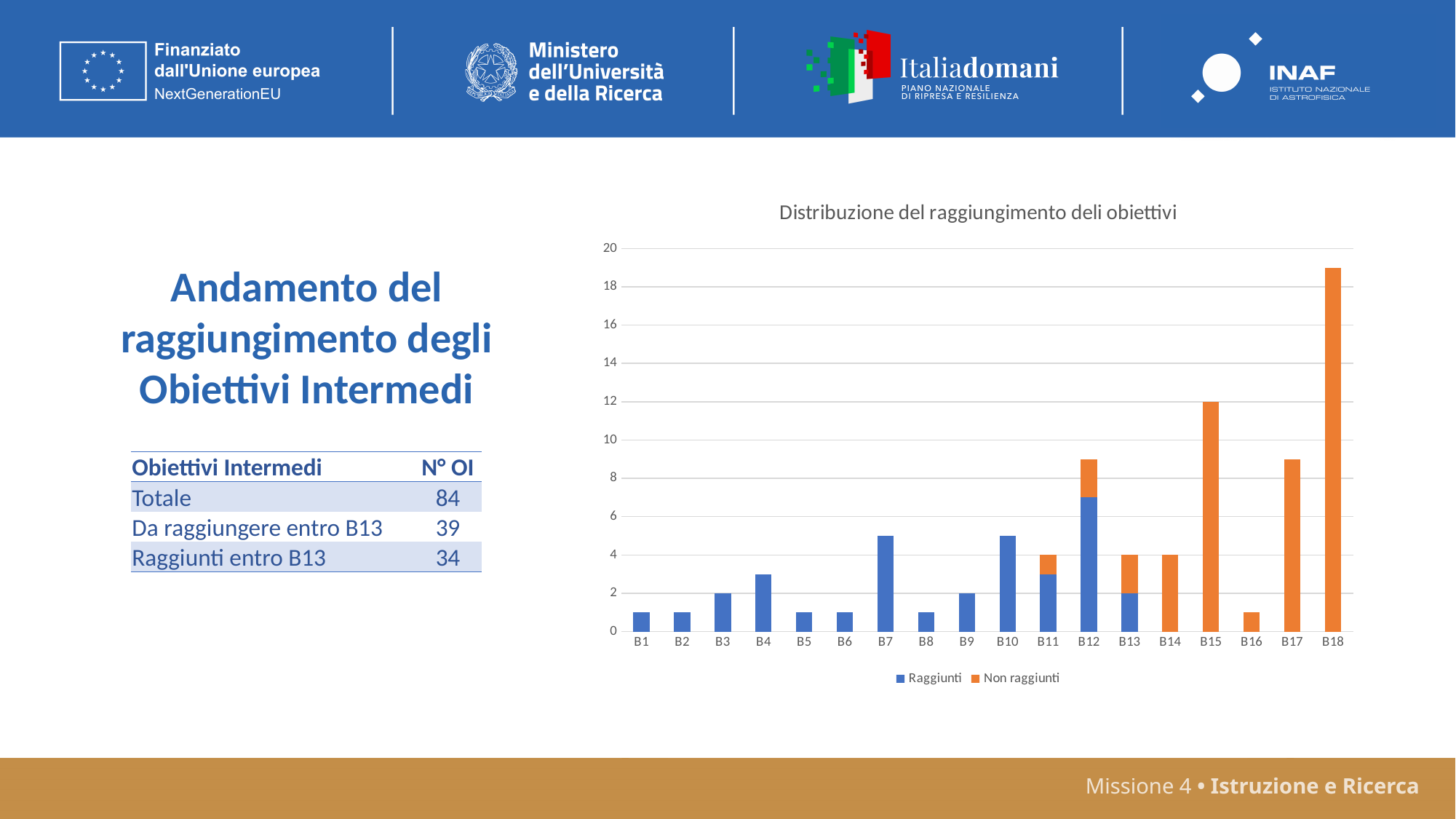
What are the two series named in the chart legend? Raggiunti and Non raggiunti How many categories (B1 to B18) are shown on the x axis of the chart? 18 How many series does the chart legend list? 2 What is the title of the chart? Distribuzione del raggiungimento deli obiettivi Which category has the tallest bar in the chart? B18 What is the value of the Non raggiunti bar for B15? 12 What is the value of the Non raggiunti bar for B14? 4 Is the value for B17 greater or less than 10? less What is the value of the Raggiunti bar for B3? 2 What kind of chart is shown on the slide? bar chart Is the value for B18 greater or less than 18? greater Which is larger, the bar for B15 or the bar for B17? B15